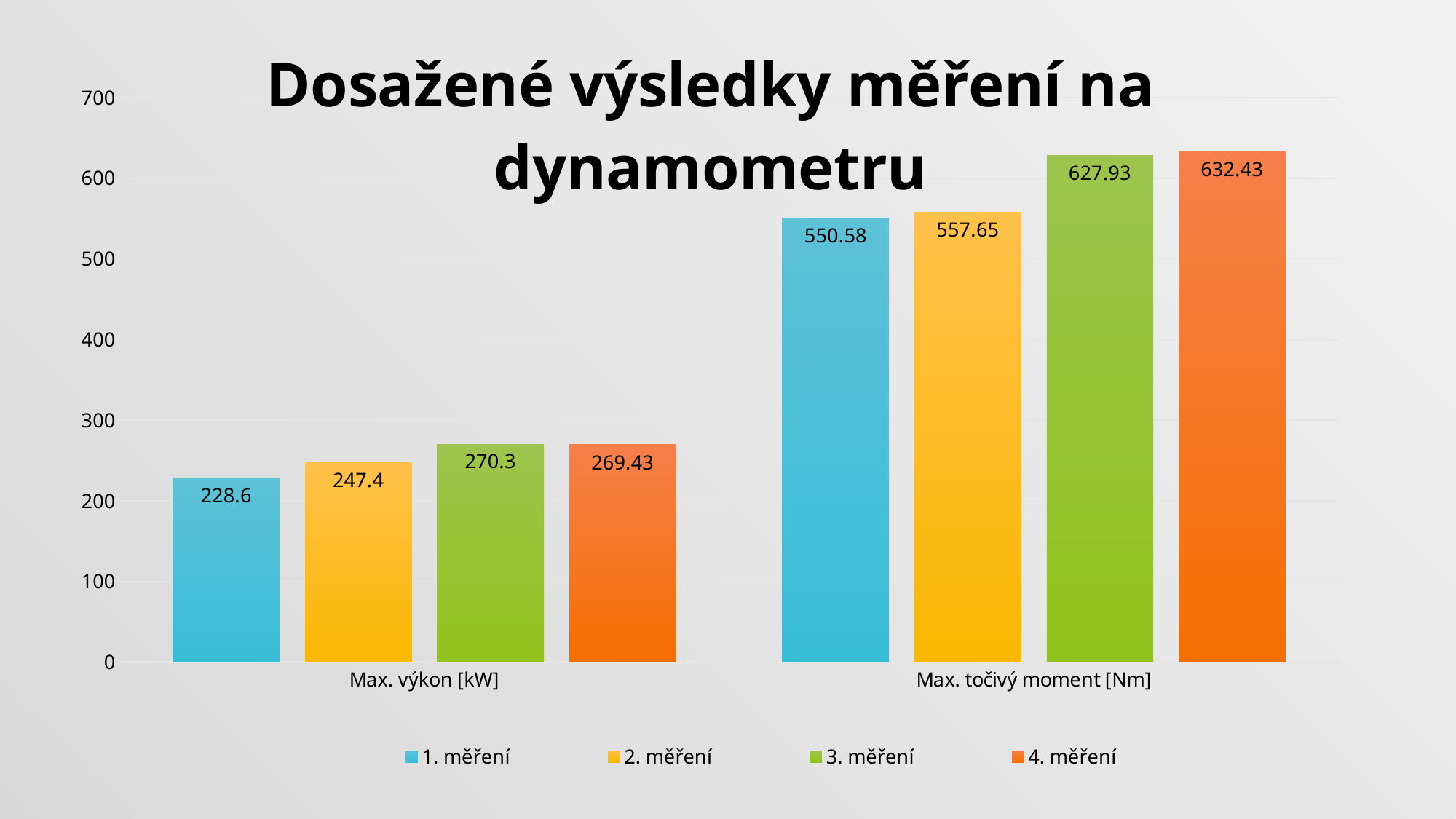
Which measurement series has the lowest value for Max. výkon [kW]? 1. měření What is the difference between 4. měření and 1. měření for Max. točivý moment [Nm]? 81.85 What is the difference between 2. měření and 1. měření for Max. výkon [kW]? 18.8 What is the value of 3. měření for Max. výkon [kW]? 270.3 What is the value of 2. měření for Max. točivý moment [Nm]? 557.65 Which measurement series has the lowest value for Max. točivý moment [Nm]? 1. měření What is the value of 1. měření for Max. výkon [kW]? 228.6 What is the value of 4. měření for Max. točivý moment [Nm]? 632.43 What kind of chart is shown on the slide? Bar chart Which is larger for Max. točivý moment [Nm]: 1. měření or 3. měření? 3. měření How many series does the legend list? 4 What is the title of the chart? Dosažené výsledky měření na dynamometru